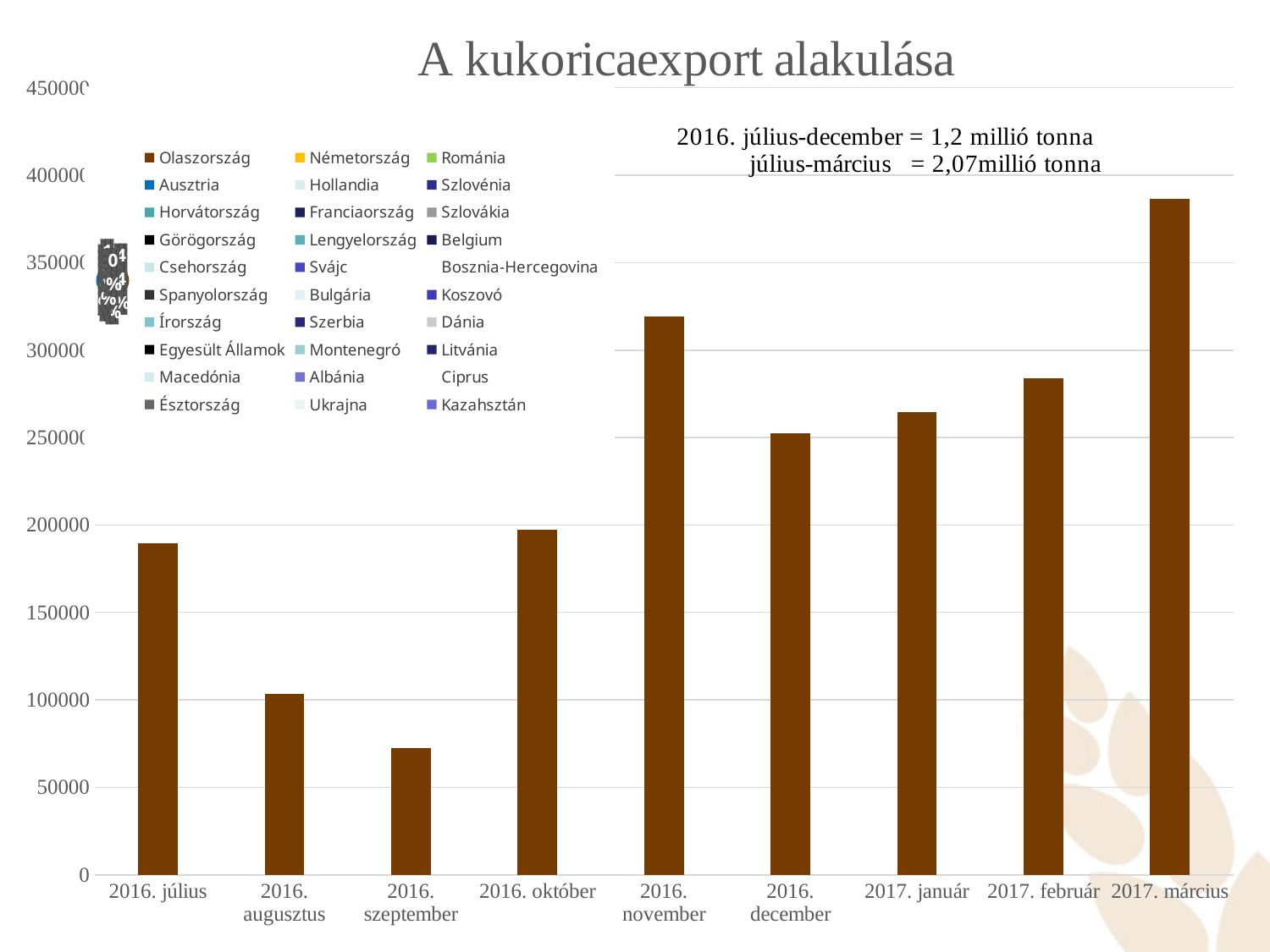
According to the text on the slide, what was the total export for 2016. július-december? 1,2 millió tonna Which month has the lowest bar? 2016. szeptember Which is larger, the value for 2016. július or the value for 2016. augusztus? 2016. július Is the value for 2016. augusztus greater or less than 150000? less How many months (categories) are plotted along the x axis? 9 Is the value for 2016. november greater or less than 300000? greater What is the title of the chart? A kukoricaexport alakulása Is the value for 2016. szeptember greater or less than 100000? less Which month has the highest bar? 2017. március What kind of chart is shown on the slide? bar chart Do the values rise or fall from 2016. december to 2017. március? rise